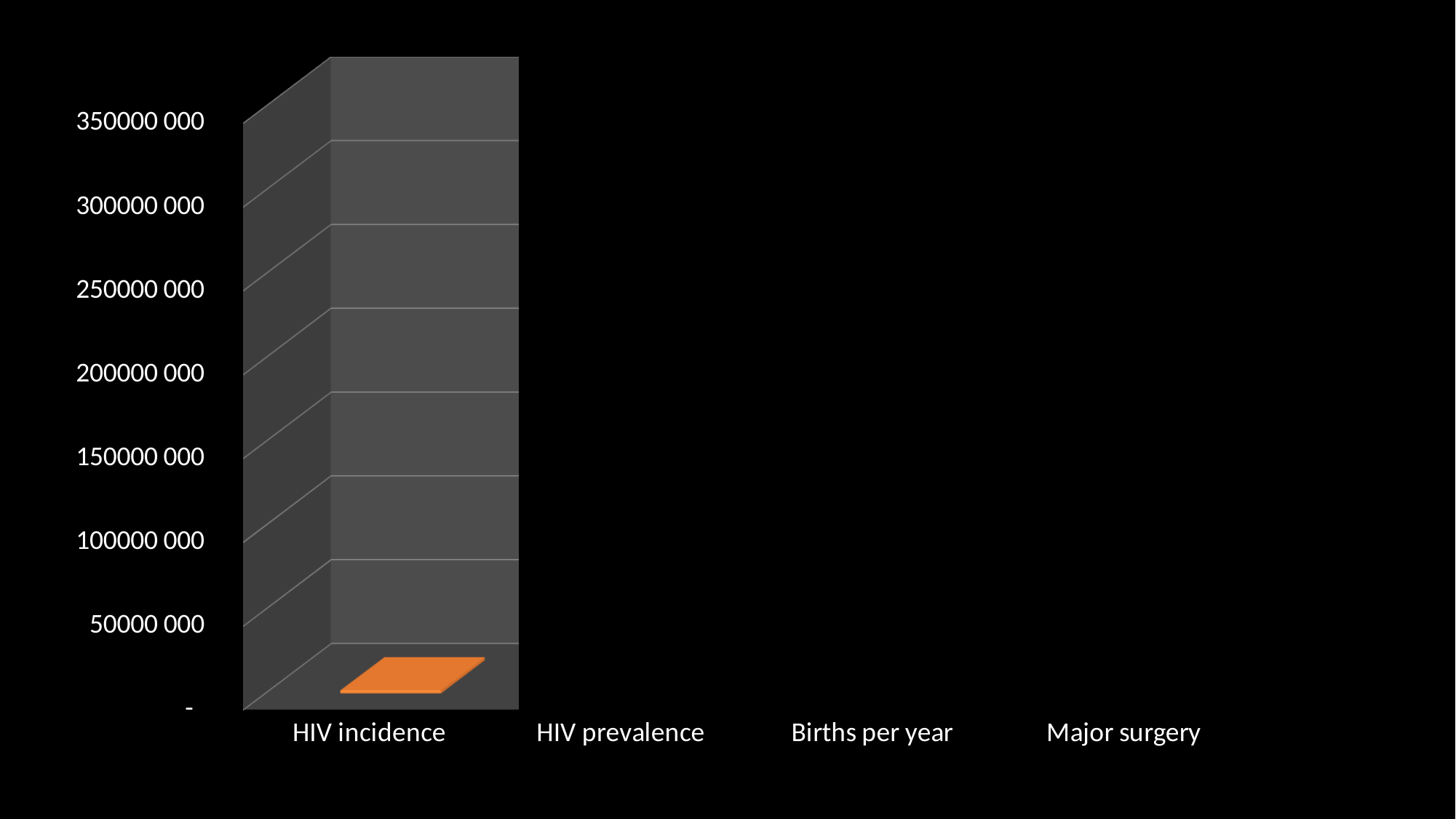
Which category is the first one listed on the x axis? HIV incidence Is the value for HIV incidence greater or less than 100000 000? less How many categories are labelled on the x axis of the chart? 4 What is the highest tick value shown on the vertical axis? 350000 000 Which category is the last one listed on the x axis? Major surgery Is the value for HIV incidence greater or less than 50000 000? less What kind of chart is shown on the slide? bar chart